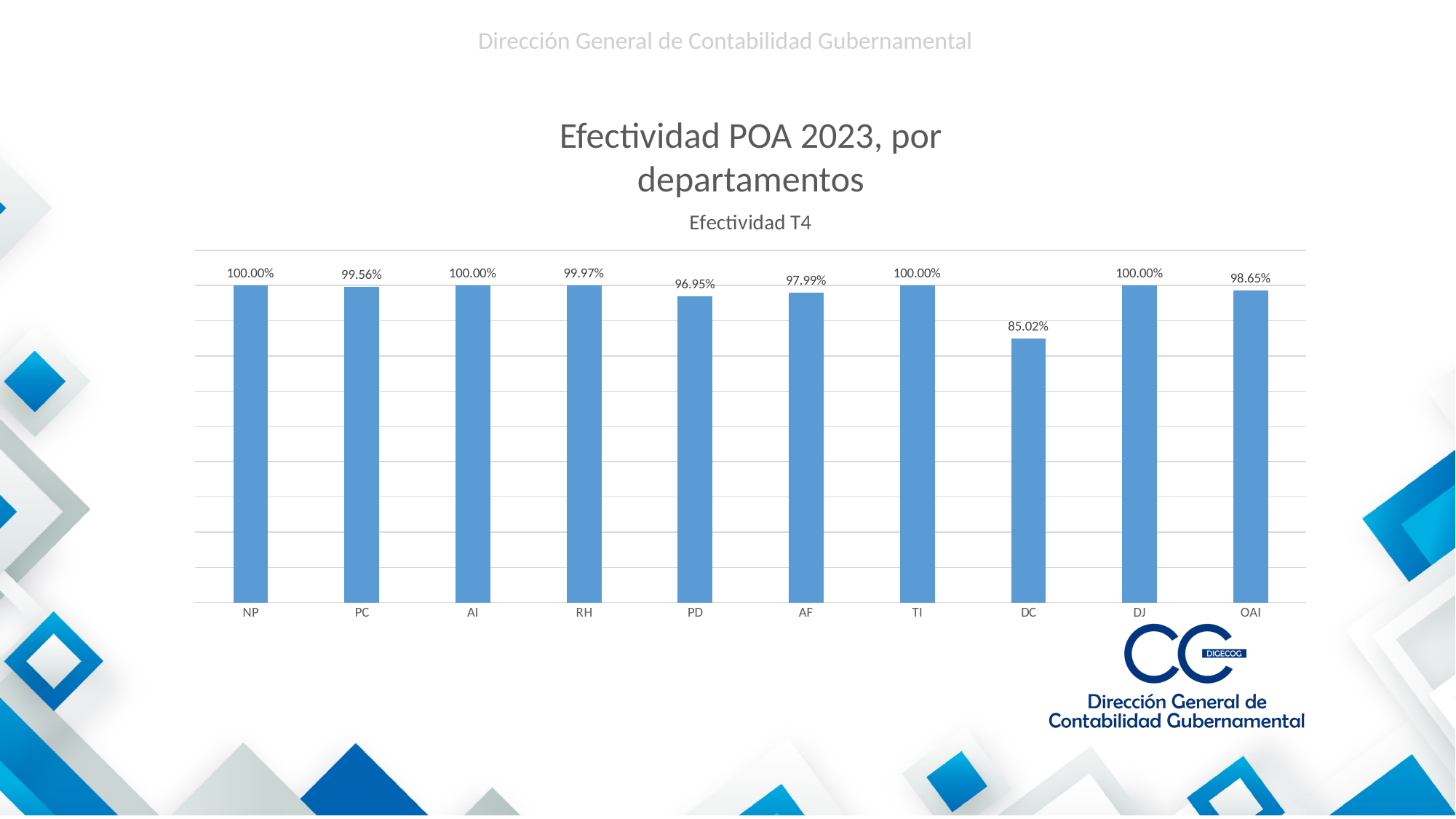
What is the Efectividad T4 value for OAI? 98.65% What is the difference between the Efectividad T4 values for AF and PD? 1.04% Which department has the lowest Efectividad T4 value? DC Which has a higher Efectividad T4 value, AF or OAI? OAI What type of chart is shown on the slide? Bar chart Which has a higher Efectividad T4 value, PD or DC? PD What is the Efectividad T4 value for DC? 85.02% What is the title of the chart? Efectividad T4 What is the Efectividad T4 value for PC? 99.56% How many departments are shown on the x axis of the chart? 10 What is the Efectividad T4 value for PD? 96.95% What is the difference between the Efectividad T4 values for RH and DC? 14.95%